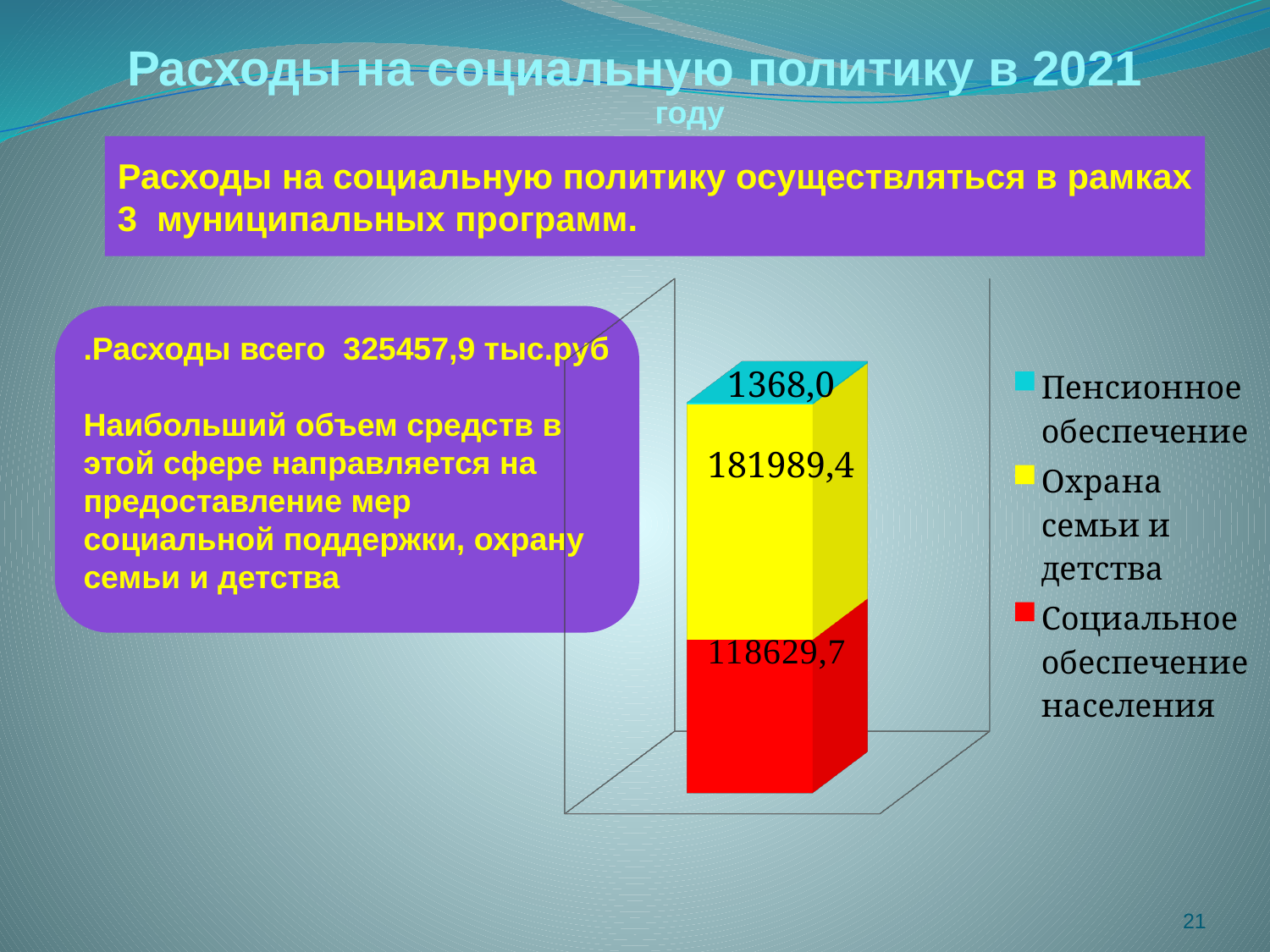
Which series has the smallest value in the stacked bar? Пенсионное обеспечение What is the difference between the values for Социальное обеспечение населения and Пенсионное обеспечение? 117261,7 Which colour represents Социальное обеспечение населения in the chart? Red Which series has the largest value in the stacked bar? Охрана семьи и детства How many series does the legend list? 3 What is the difference between the values for Охрана семьи и детства and Социальное обеспечение населения? 63359,7 What value is shown for Социальное обеспечение населения in the chart? 118629,7 What value is shown for Охрана семьи и детства in the chart? 181989,4 What kind of chart is shown on the slide? Stacked bar chart What value is shown for Пенсионное обеспечение in the chart? 1368,0 Which is larger: the value for Охрана семьи и детства or the value for Социальное обеспечение населения? Охрана семьи и детства What is the total of the stacked bar, summing the three labelled segments? 301987,1